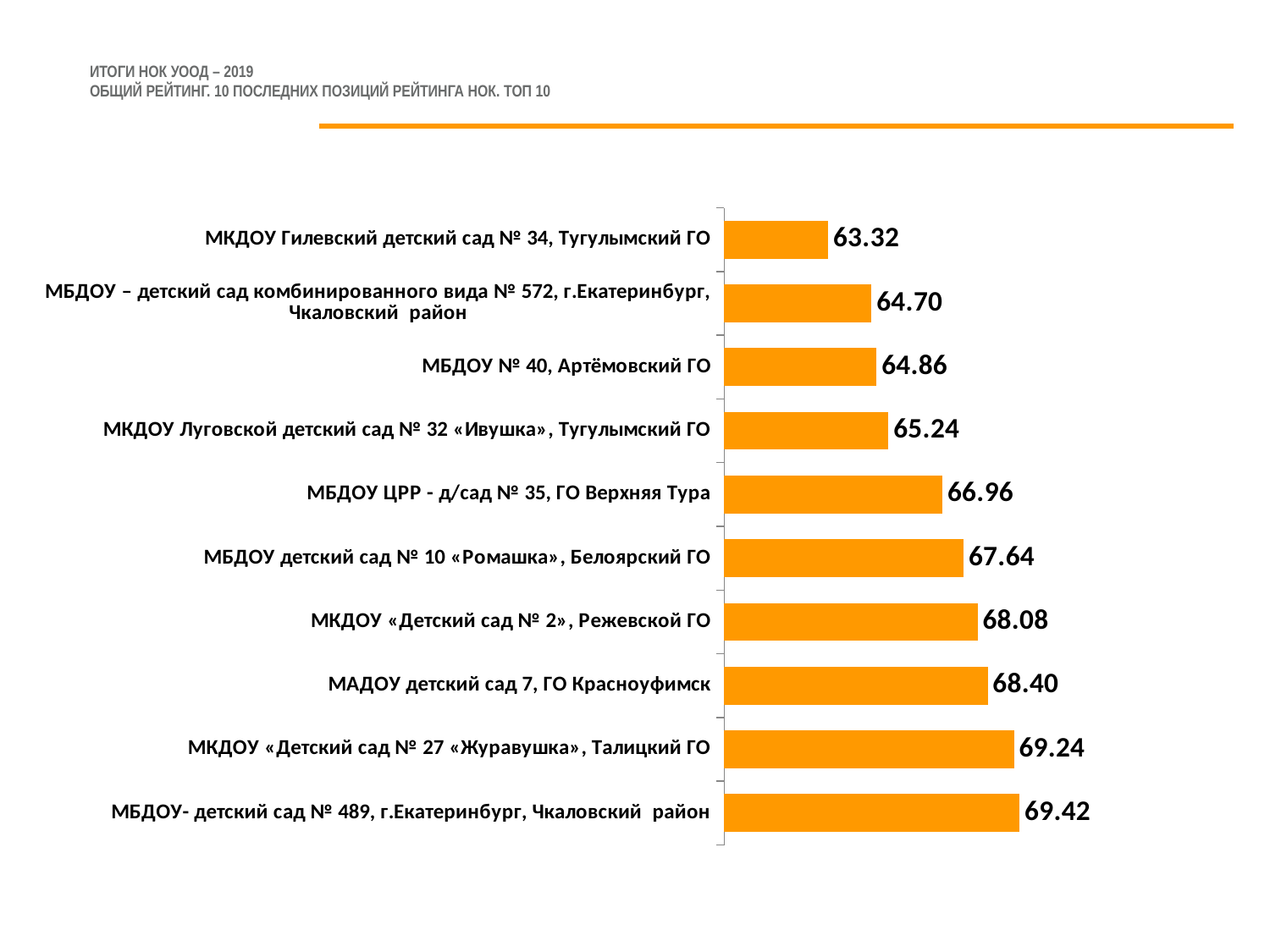
What is the difference between the values for МБДОУ- детский сад № 489, г.Екатеринбург, Чкаловский район and МКДОУ Гилевский детский сад № 34, Тугулымский ГО? 6.10 Which has a larger value: МБДОУ детский сад № 10 «Ромашка», Белоярский ГО or МБДОУ № 40, Артёмовский ГО? МБДОУ детский сад № 10 «Ромашка», Белоярский ГО Which category has the lowest value? МКДОУ Гилевский детский сад № 34, Тугулымский ГО How many categories are shown in the chart? 10 What kind of chart is shown on the slide? Bar chart What is the value for МКДОУ «Детский сад № 2», Режевской ГО? 68.08 Which category has the highest value? МБДОУ- детский сад № 489, г.Екатеринбург, Чкаловский район What colour are the bars in the chart? Orange What is the difference between the values for МБДОУ ЦРР - д/сад № 35, ГО Верхняя Тура and МКДОУ Луговской детский сад № 32 «Ивушка», Тугулымский ГО? 1.72 What is the value for МБДОУ ЦРР - д/сад № 35, ГО Верхняя Тура? 66.96 What is the value for МБДОУ № 40, Артёмовский ГО? 64.86 What is the value for МАДОУ детский сад 7, ГО Красноуфимск? 68.40